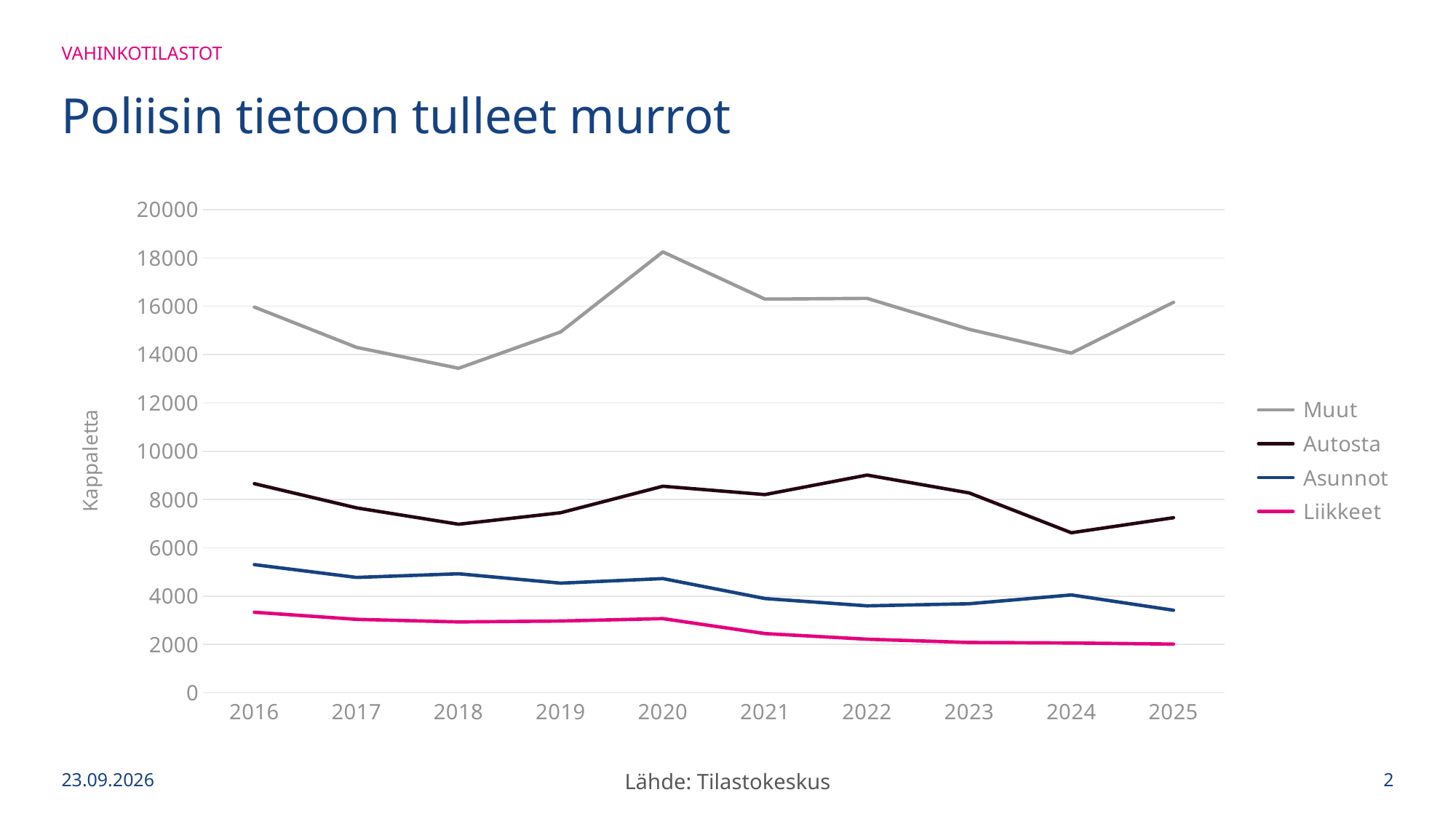
Is the value for Asunnot in 2016 greater or less than 4000? greater Is the value for Autosta in 2024 greater or less than 8000? less In which year does the Muut series reach its lowest value? 2018 In which year does the Autosta series reach its lowest value? 2024 How many series does the legend list? 4 How many years are shown on the x axis? 10 Does the Liikkeet series generally rise or fall from 2016 to 2025? fall What kind of chart is shown on the slide? line chart Is the value for Muut in 2020 greater or less than 16000? greater In 2020, which series has the larger value, Autosta or Asunnot? Autosta In which year does the Muut series reach its highest value? 2020